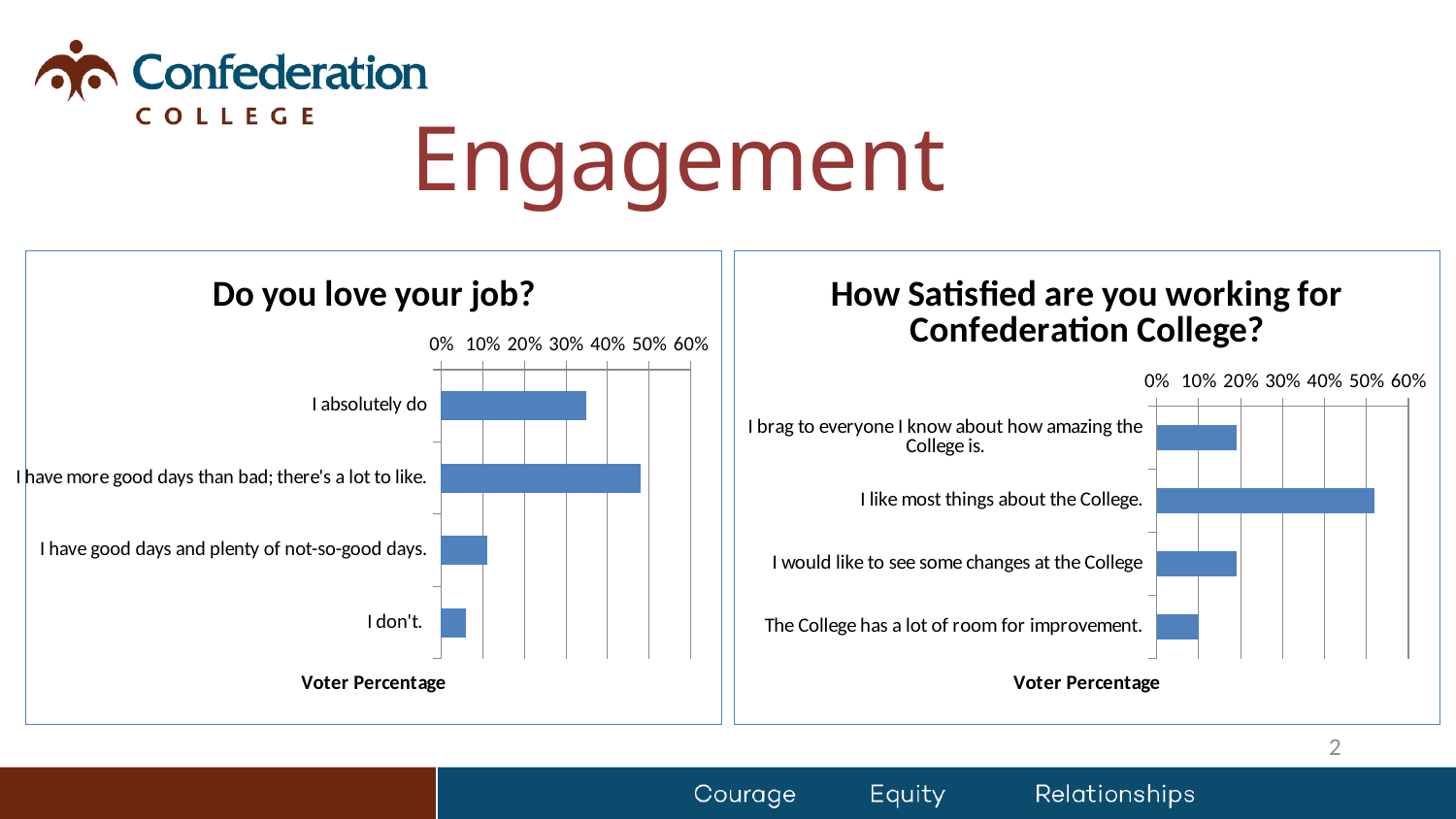
In the chart titled "Do you love your job?", is the value for "I absolutely do" greater or less than 30%? greater In the chart titled "How Satisfied are you working for Confederation College?", which response has the lowest voter percentage? The College has a lot of room for improvement. In the chart titled "Do you love your job?", which response has the lowest voter percentage? I don't. In the chart titled "Do you love your job?", which response has the highest voter percentage? I have more good days than bad; there's a lot to like. In the chart titled "How Satisfied are you working for Confederation College?", is the value for "I like most things about the College." greater or less than 40%? greater In the chart titled "Do you love your job?", which is larger: the value for "I absolutely do" or the value for "I don't."? I absolutely do What kind of chart is the chart titled "How Satisfied are you working for Confederation College?"? Bar chart In the chart titled "How Satisfied are you working for Confederation College?", is the value for "The College has a lot of room for improvement." greater or less than 20%? less How many response categories are shown in the chart titled "Do you love your job?"? 4 In the chart titled "How Satisfied are you working for Confederation College?", which response has the highest voter percentage? I like most things about the College. What is the axis title shown below the bars in the chart titled "Do you love your job?"? Voter Percentage